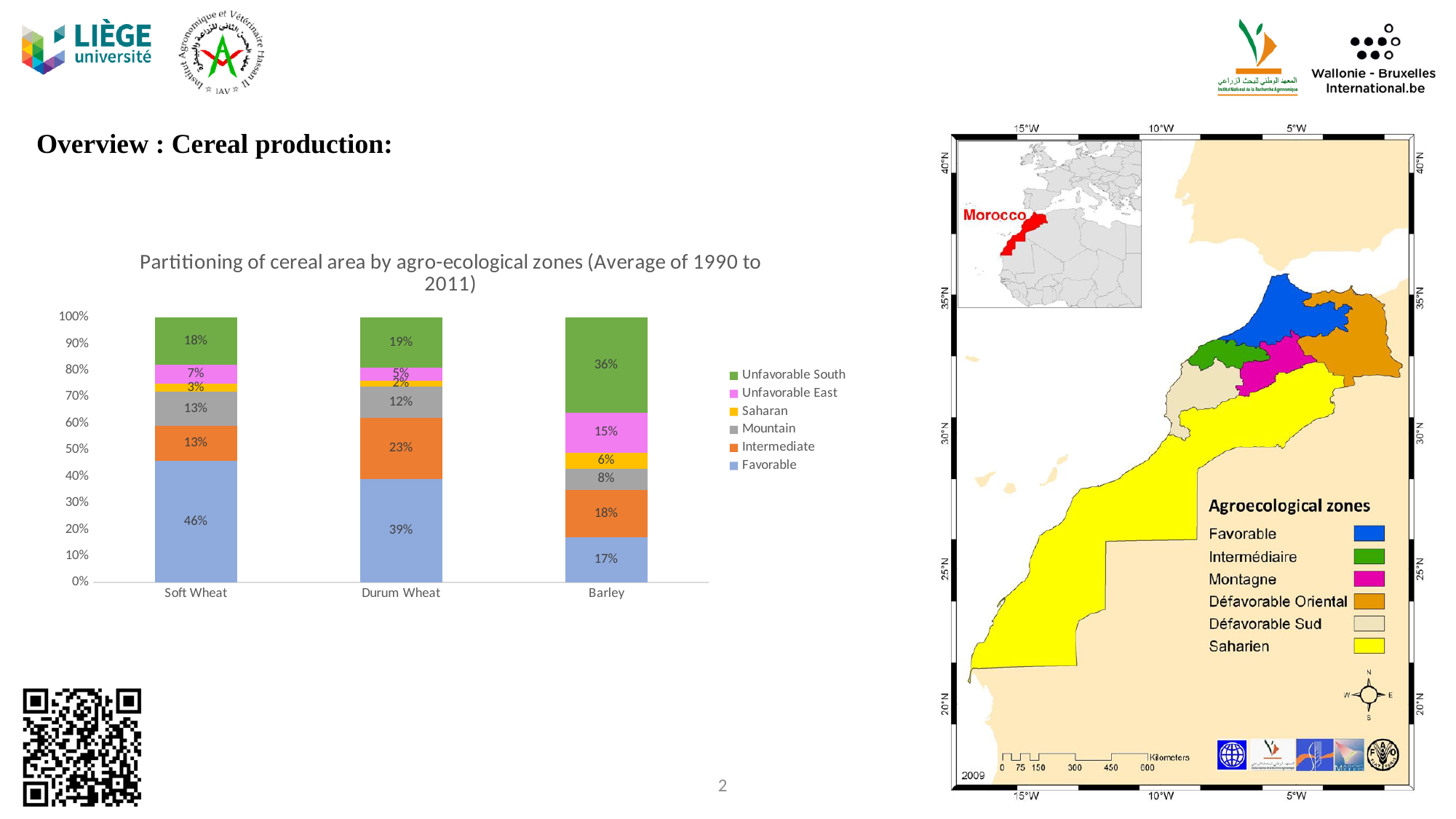
How many cereal categories are shown on the x axis? 3 What is the Saharan share for Barley? 6% Which cereal has the lowest Unfavorable South share? Soft Wheat What is the Unfavorable South share for Barley? 36% How many series does the legend list? 6 Is the Mountain share larger for Soft Wheat or for Barley? Soft Wheat Which cereal has the highest Favorable share? Soft Wheat What is the difference between the Favorable share for Soft Wheat and for Barley? 29% What is the title of the chart? Partitioning of cereal area by agro-ecological zones (Average of 1990 to 2011) What is the Favorable share for Soft Wheat? 46% What kind of chart is shown? Stacked bar chart What is the Intermediate share for Durum Wheat? 23%